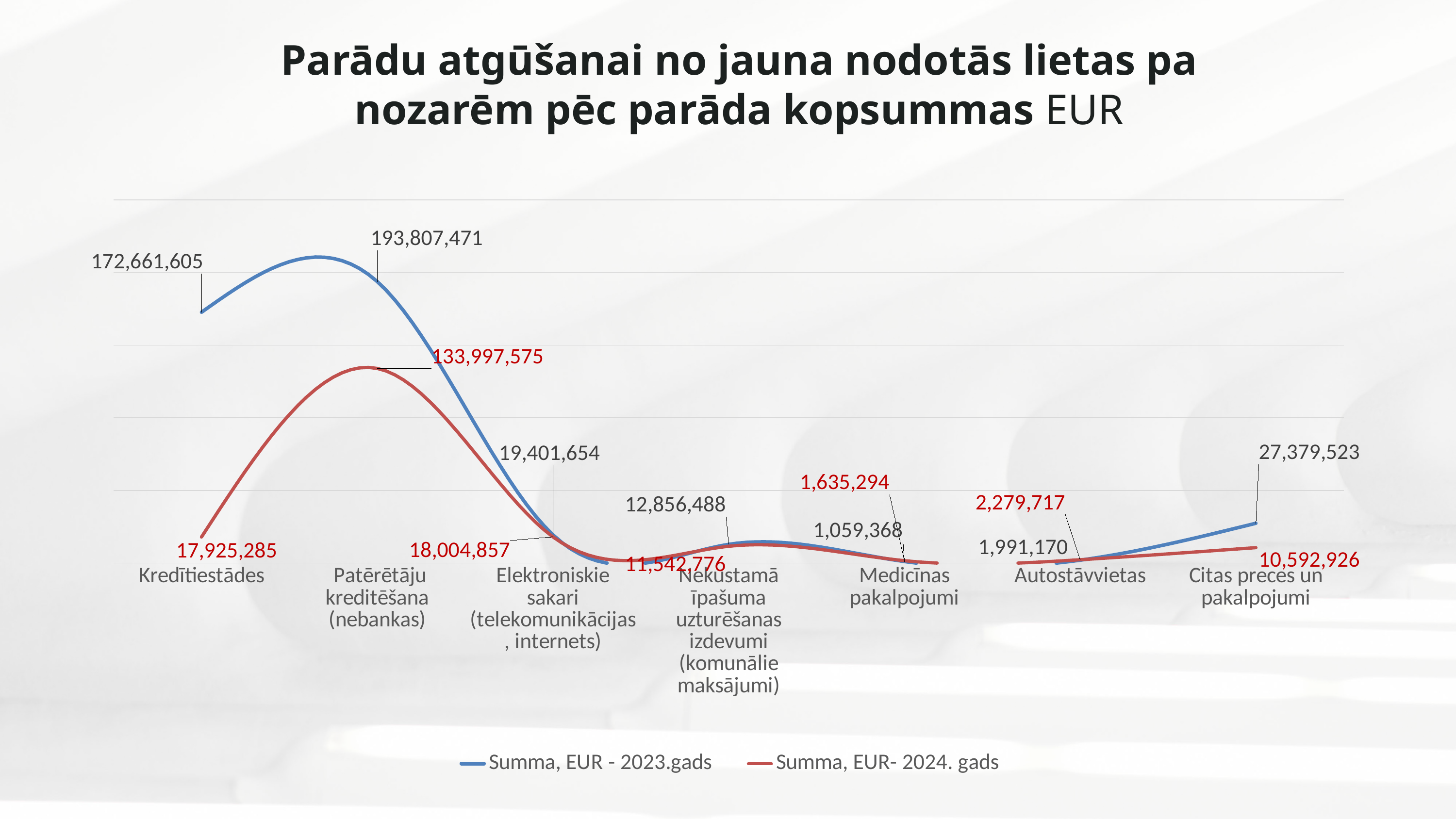
How many categories are shown on the x axis? 7 What type of chart is shown on the slide? line chart Which category has the highest value in the series Summa, EUR - 2023.gads? Patērētāju kreditēšana (nebankas) What is the value for Patērētāju kreditēšana (nebankas) in the series Summa, EUR- 2024. gads? 133,997,575 What is the value for Kredītiestādes in the series Summa, EUR - 2023.gads? 172,661,605 What is the difference between the 2023 and 2024 values for Patērētāju kreditēšana (nebankas)? 59,809,896 Which category has the lowest value in the series Summa, EUR- 2024. gads? Medicīnas pakalpojumi For Medicīnas pakalpojumi, which series has the larger value: Summa, EUR - 2023.gads or Summa, EUR- 2024. gads? Summa, EUR- 2024. gads What colour is the line for the series Summa, EUR- 2024. gads? red How many series does the legend list? 2 What is the value for Citas preces un pakalpojumi in the series Summa, EUR - 2023.gads? 27,379,523 What is the value for Medicīnas pakalpojumi in the series Summa, EUR- 2024. gads? 1,635,294